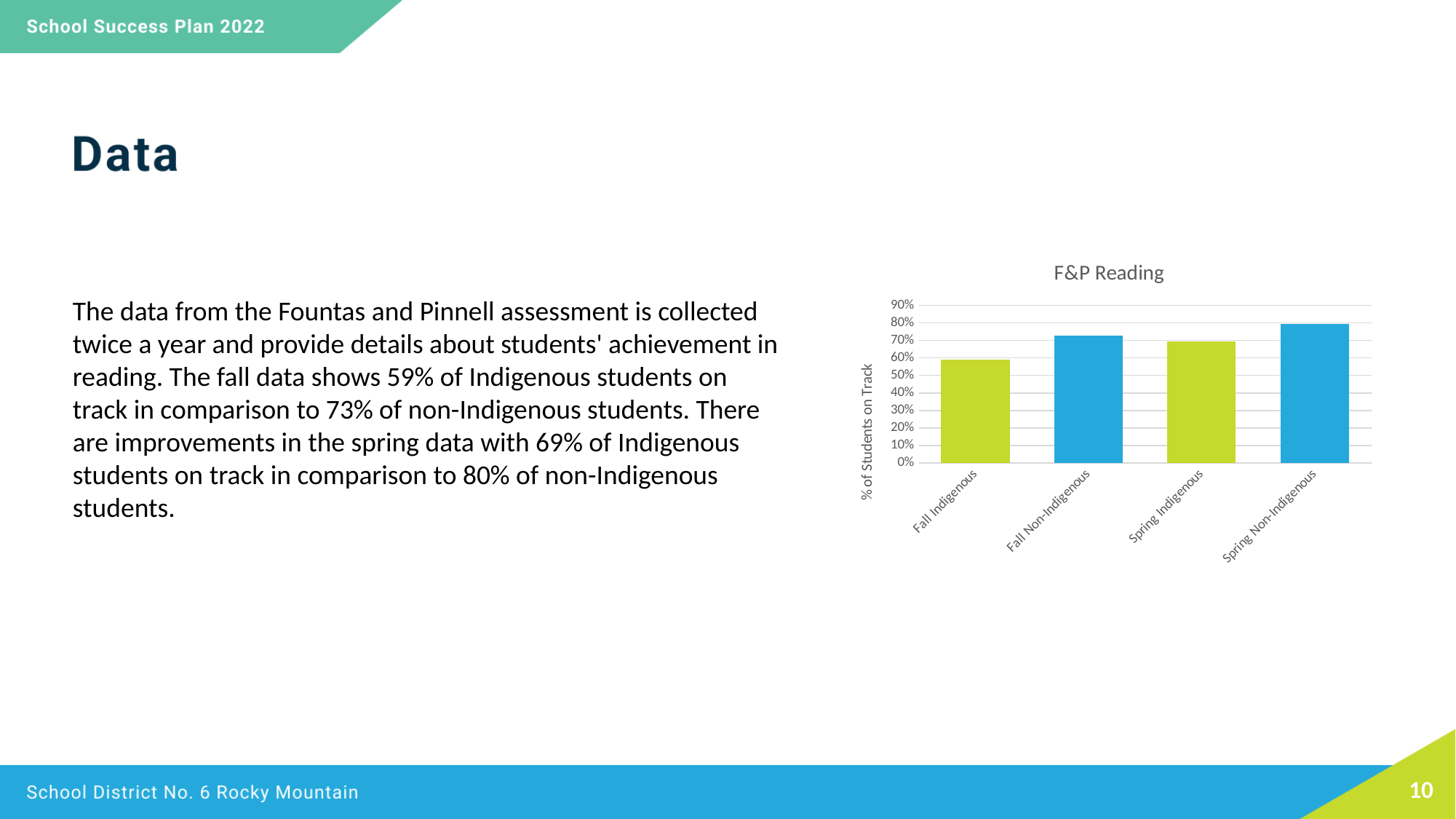
Which is larger, the value for Fall Non-Indigenous or the value for Spring Non-Indigenous? Spring Non-Indigenous Is the value for Spring Non-Indigenous greater or less than 70%? greater Which category has the highest value in the F&P Reading chart? Spring Non-Indigenous What kind of chart is shown on the slide? bar chart What is the label of the vertical axis in the F&P Reading chart? % of Students on Track Which is larger, the value for Spring Indigenous or the value for Fall Indigenous? Spring Indigenous What is the title of the chart? F&P Reading Which category has the lowest value in the F&P Reading chart? Fall Indigenous Is the value for Fall Non-Indigenous greater or less than 60%? greater Is the value for Fall Indigenous greater or less than 50%? greater According to the slide, what percentage of Indigenous students were on track in the fall? 59% How many categories are plotted in the F&P Reading chart? 4